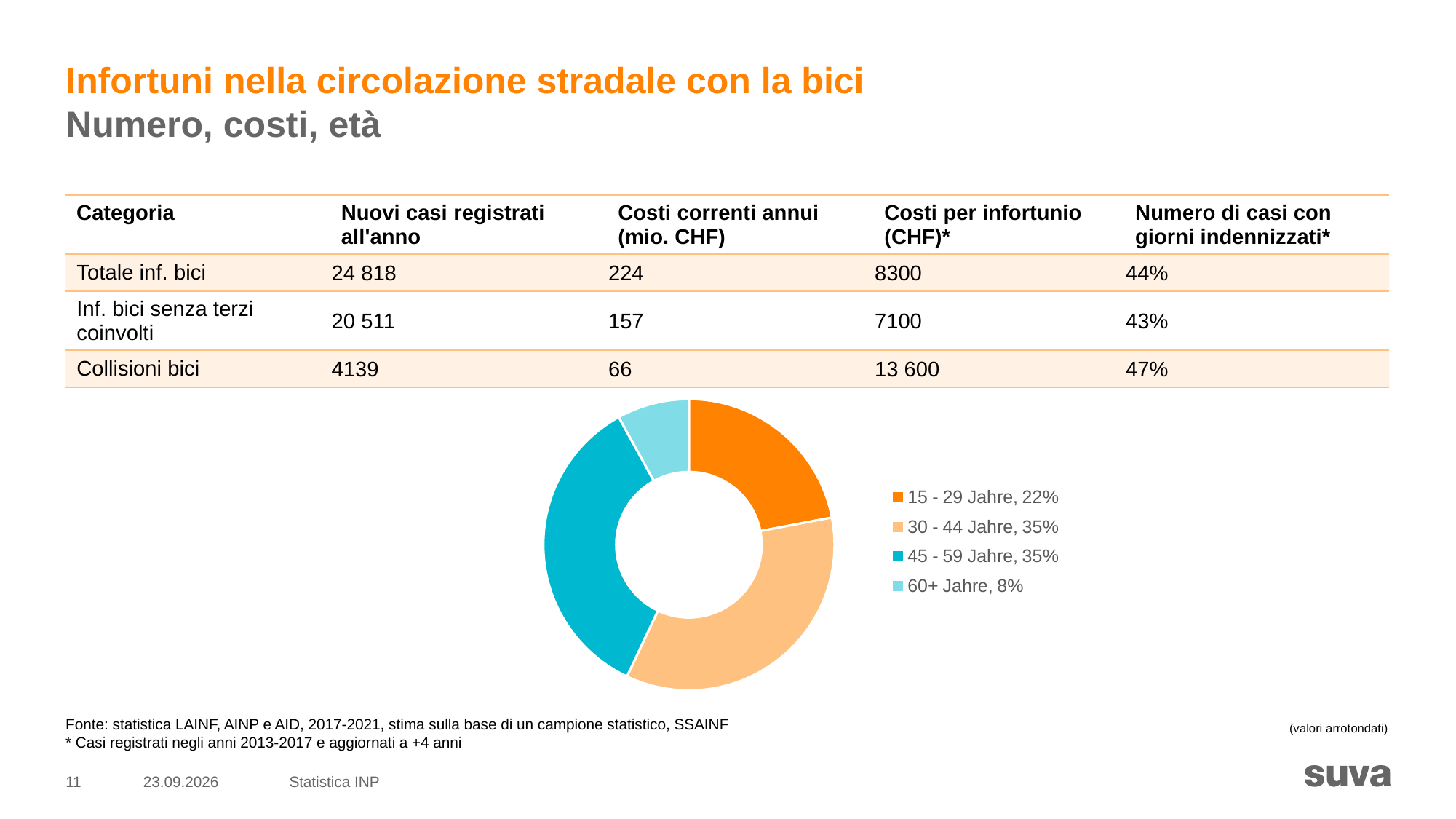
What share of the donut chart is the 30 - 44 Jahre category? 35% What is the difference in percentage points between the 15 - 29 Jahre share and the 60+ Jahre share in the donut chart? 14 percentage points What colour is the 45 - 59 Jahre slice in the donut chart? Teal (dark cyan) Which has the larger share in the donut chart, 15 - 29 Jahre or 60+ Jahre? 15 - 29 Jahre What share of the donut chart is the 45 - 59 Jahre category? 35% How many age categories does the donut chart show? 4 Which has the larger share in the donut chart, 30 - 44 Jahre or 15 - 29 Jahre? 30 - 44 Jahre What share of the donut chart is the 60+ Jahre category? 8% What kind of chart is shown on the slide? Donut (pie) chart What is the difference in percentage points between the 45 - 59 Jahre share and the 15 - 29 Jahre share in the donut chart? 13 percentage points Which age category has the smallest share in the donut chart? 60+ Jahre